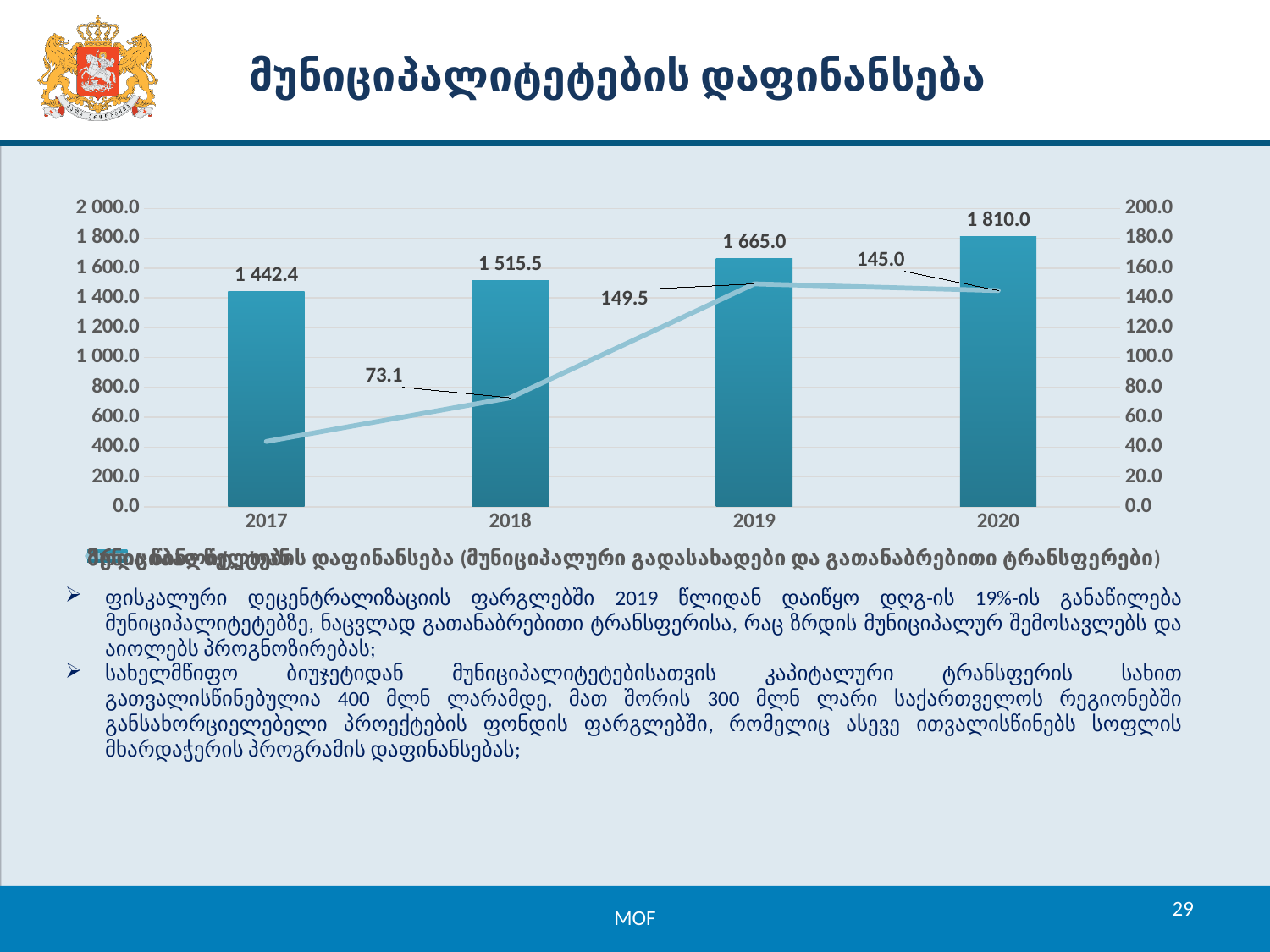
What is the value of the bar for 2020? 1 810.0 What is the difference between the bar values for 2020 and 2019? 145.0 What is the value of the bar for 2018? 1 515.5 Is the value of the line for 2017 greater or less than 60.0 on the right axis? less Which year has the highest bar? 2020 What is the value of the line for 2018? 73.1 What is the value of the bar for 2017? 1 442.4 How many years are shown on the x axis? 4 Which bar is larger, 2018 or 2019? 2019 Do the bar values rise or fall from 2017 to 2020? rise Which year has the lowest bar? 2017 What is the value of the line for 2019? 149.5